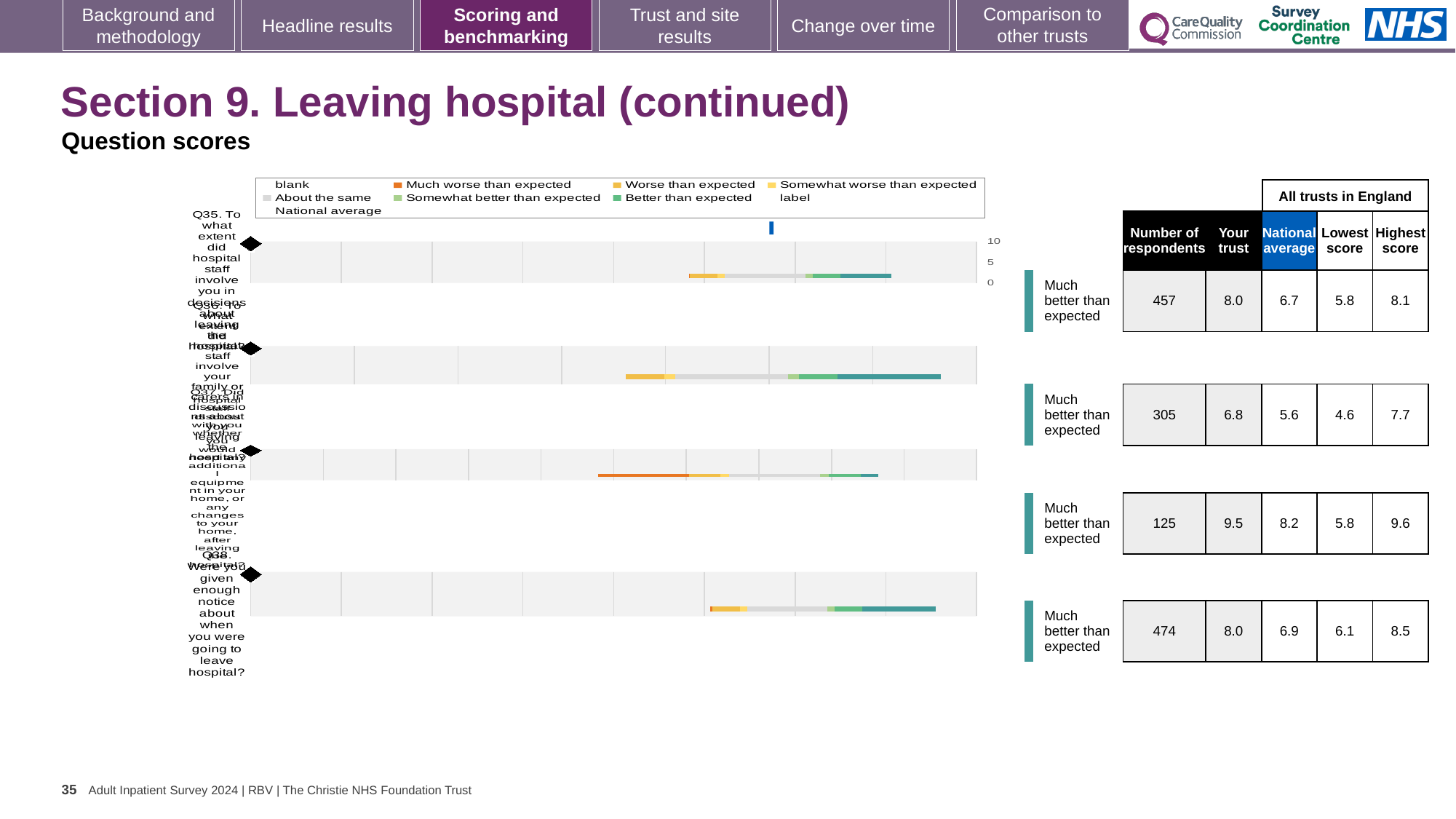
What kind of chart is shown on the slide? bar chart Which legend entry is shown with an orange colour in the chart? Much worse than expected In the table beside the chart, is the 'Your trust' score for the first row (Q35) larger or smaller than the national average? larger In the table beside the chart, what is the highest score for the last row (Q38)? 8.5 In the table beside the chart, which row has the highest 'Your trust' score? Q37 (third row), 9.5 In the table beside the chart, what is the 'Your trust' score for the first row (Q35)? 8.0 How many question bars are plotted in the chart? 4 Which legend entry is shown with a light grey colour in the chart? About the same In the table beside the chart, what is the number of respondents for the first row (Q35)? 457 In the table beside the chart, what is the difference between the 'Your trust' score and the national average for the second row (Q36)? 1.2 In the table beside the chart, what is the national average for the third row (Q37)? 8.2 In the table beside the chart, which row has the lowest number of respondents? Q37 (third row), 125